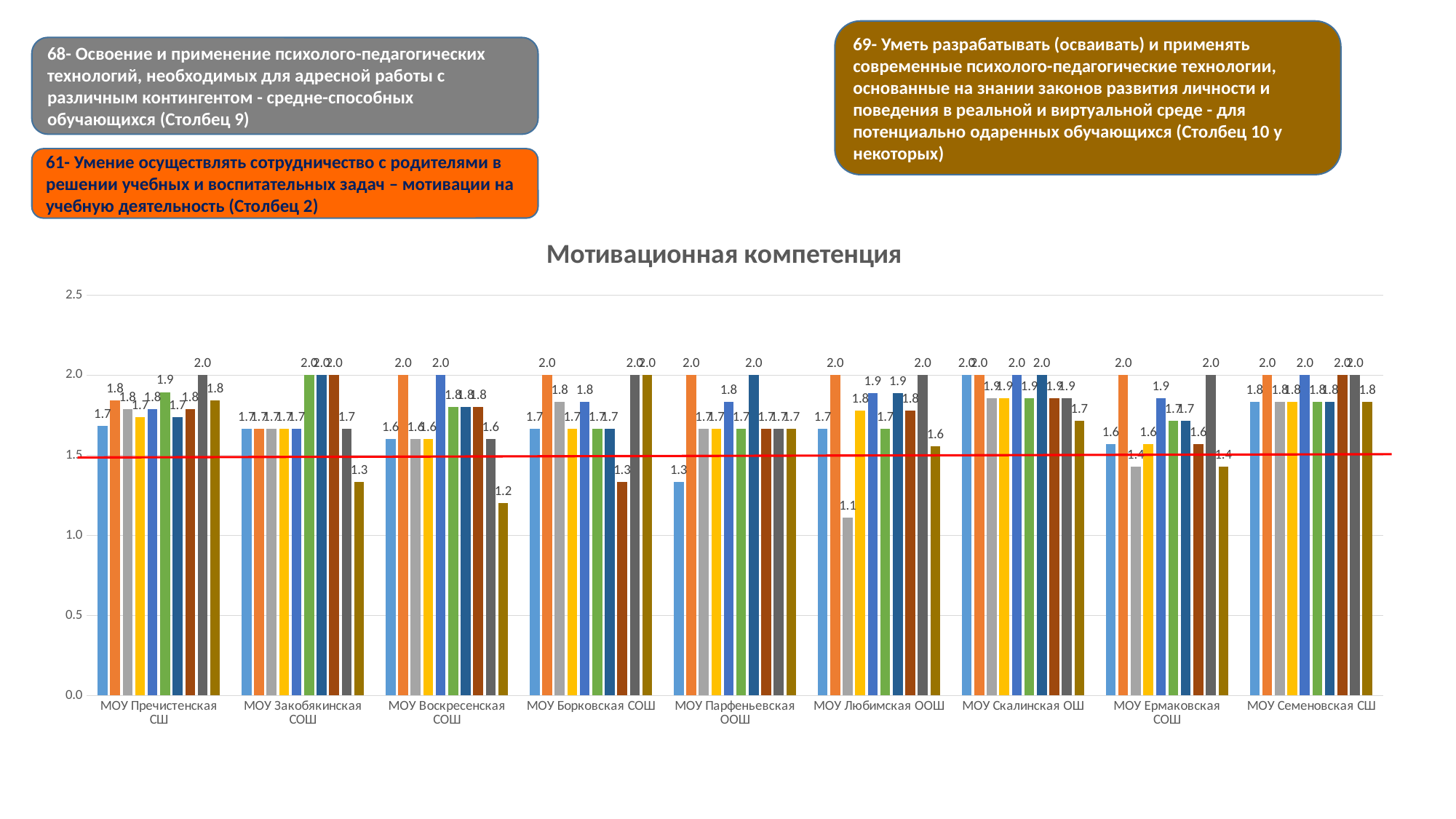
What is the value of the last (olive) bar for МОУ Воскресенская СОШ? 1.2 Is the value of the grey bar for МОУ Любимская ООШ greater or less than 1.5? less What is the difference between the highest (2.0) and lowest (1.1) values in the МОУ Любимская ООШ group? 0.9 What is the value of the first (blue) bar for МОУ Парфеньевская ООШ? 1.3 How many schools (categories) are shown on the x axis of the chart? 9 Which school group contains the lowest single value on the chart? МОУ Любимская ООШ Which is larger: the first (blue) bar for МОУ Пречистенская СШ or the first (blue) bar for МОУ Парфеньевская ООШ? МОУ Пречистенская СШ What is the title of the chart? Мотивационная компетенция What kind of chart is shown on the slide? bar chart What is the lowest value labelled in the МОУ Любимская ООШ group? 1.1 At what level does the red horizontal line cross the y axis of the chart? 1.5 What is the value of the last (olive) bar for МОУ Закобякинская СОШ? 1.3